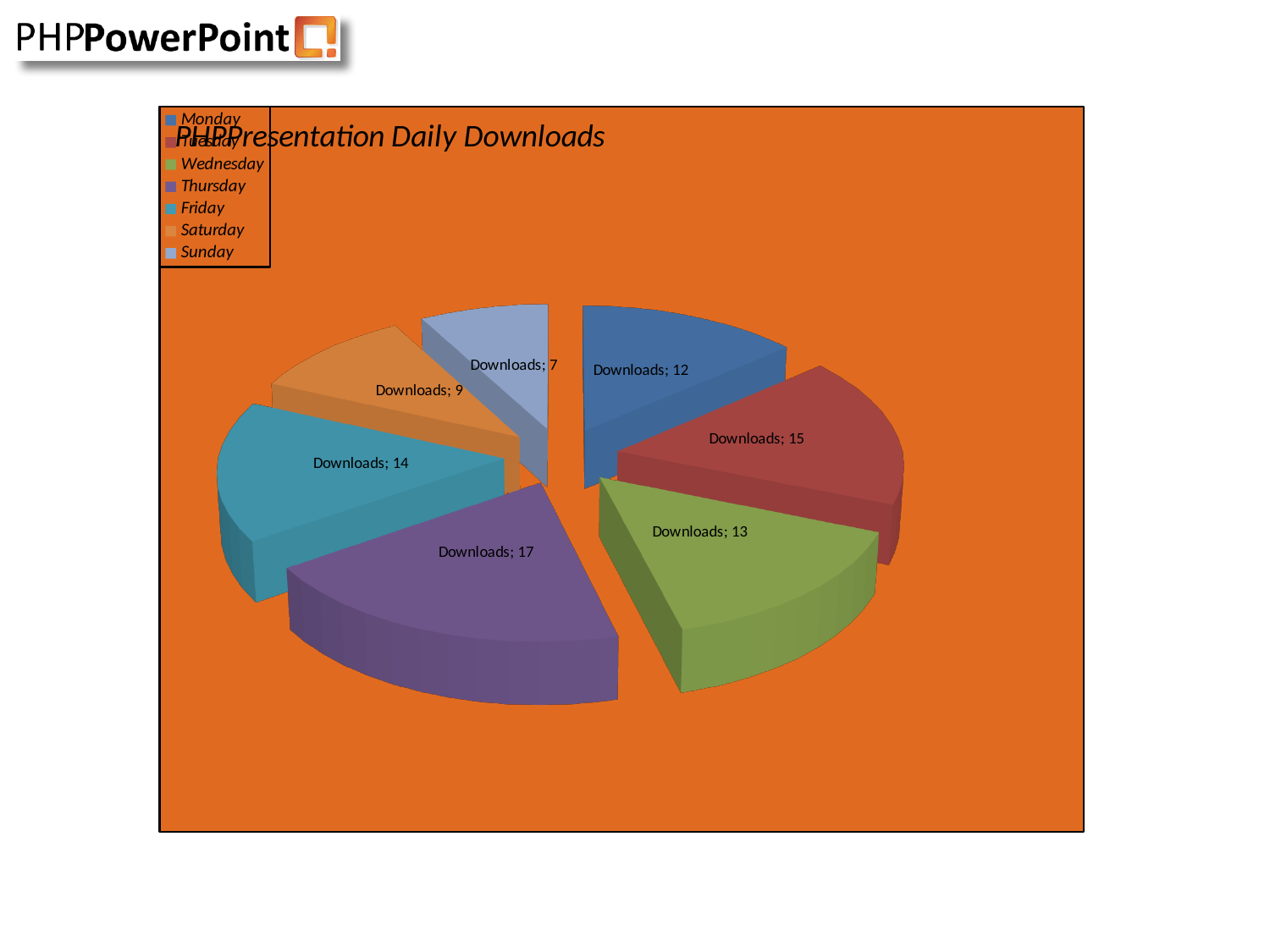
What is the difference in downloads between Thursday and Sunday? 10 Which has more downloads, Wednesday or Saturday? Wednesday What is the title of the chart? PHPPresentation Daily Downloads What is the Downloads value for Sunday? 7 What is the difference in downloads between Friday and Saturday? 5 Which day has the lowest number of downloads? Sunday What is the Downloads value for Friday? 14 What is the Downloads value for Thursday? 17 What kind of chart is shown on the slide? pie chart Which day has the highest number of downloads? Thursday What is the Downloads value for Monday? 12 How many categories (days) does the pie chart have? 7